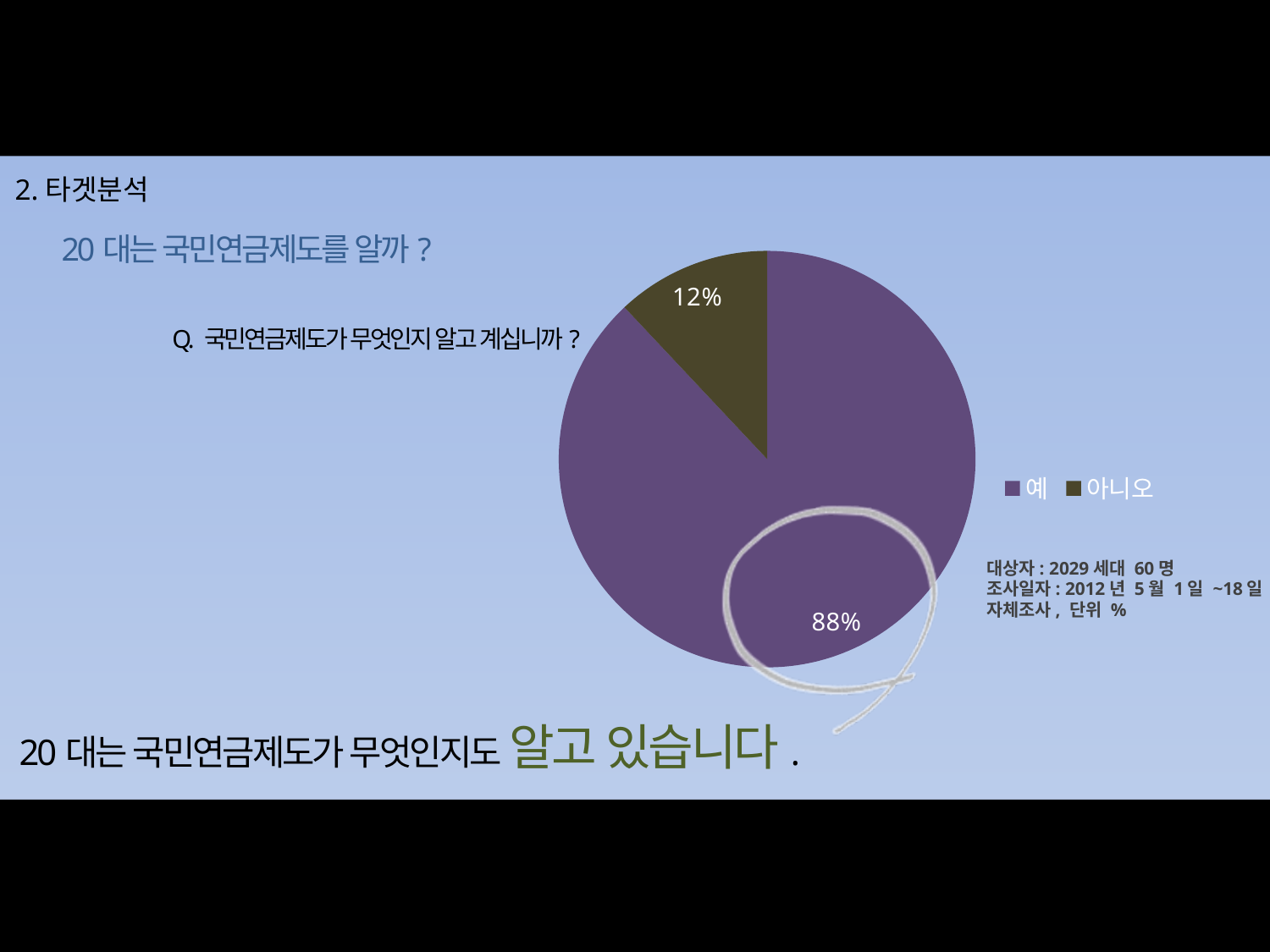
What is the difference in percentage points between the 예 slice and the 아니오 slice? 76 What kind of chart is shown on the slide? pie chart Which slice of the pie is the largest? 예 Which slice of the pie is the smallest? 아니오 What share of the pie does 아니오 (no) take? 12% How many entries does the legend list? 2 How many slices does the pie chart have? 2 What colour is the 예 slice in the pie chart? purple Which is larger, the 예 slice or the 아니오 slice? 예 What colour is the 아니오 slice in the pie chart? dark olive/brown What share of the pie does 예 (yes) take? 88%